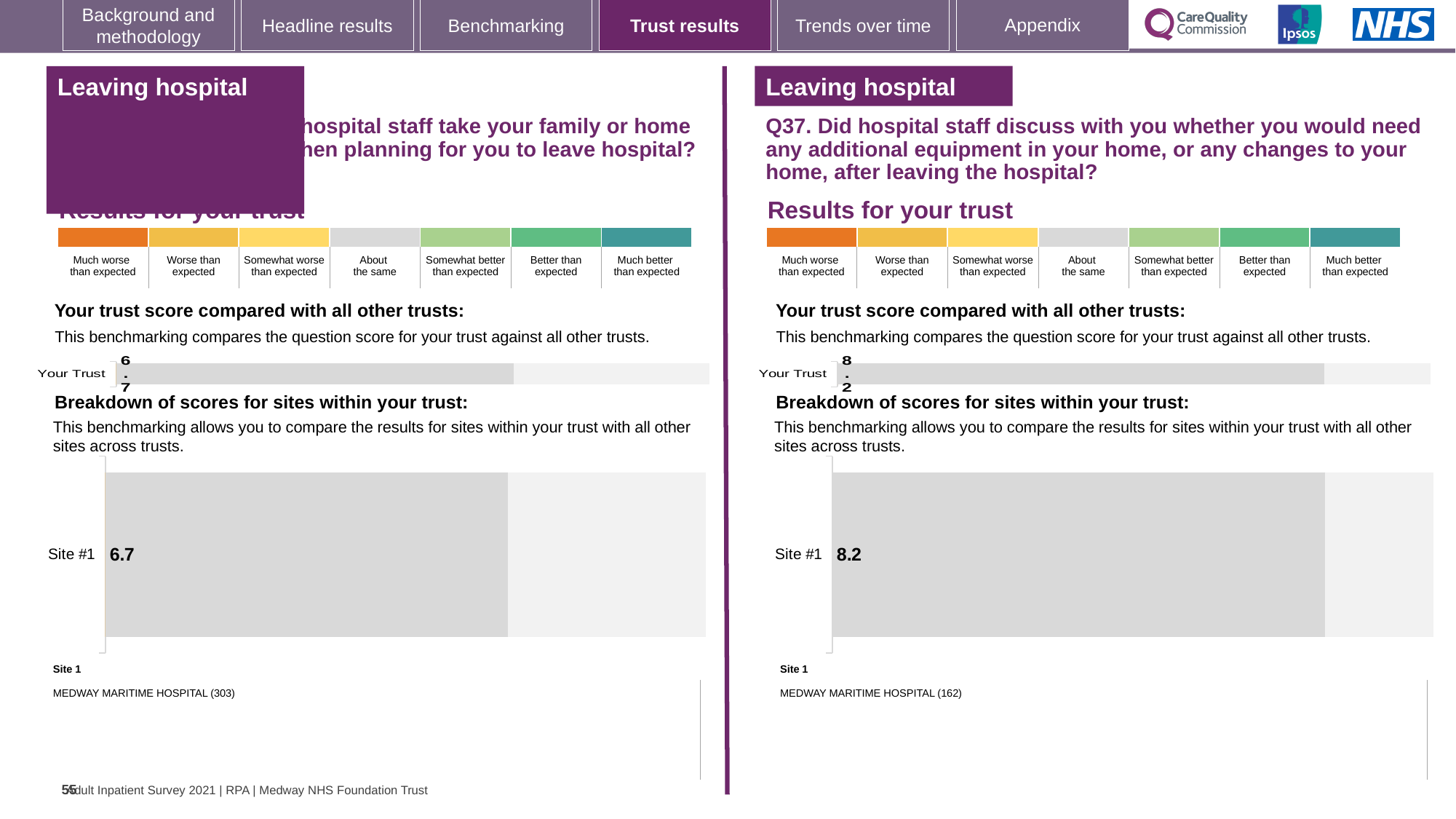
On the left panel, what is the score shown for Site #1? 6.7 Which hospital is listed as Site 1 on the left panel? MEDWAY MARITIME HOSPITAL (303) Which is larger: the Site #1 score on the left panel or the Site #1 score on the right panel (Q37)? Right panel (Q37) On the left panel, what is the score shown for Your Trust? 6.7 What kind of chart is used to show the Site #1 score on the right panel (Q37)? Bar chart On the right panel (Q37), what is the score shown for Site #1? 8.2 On the right panel (Q37), what is the score shown for Your Trust? 8.2 Which hospital is listed as Site 1 on the right panel (Q37)? MEDWAY MARITIME HOSPITAL (162) What is the difference between the Site #1 score on the right panel (Q37) and the Site #1 score on the left panel? 1.5 How many sites are shown in the site breakdown chart on the right panel (Q37)? 1 How many sites are shown in the site breakdown chart on the left panel? 1